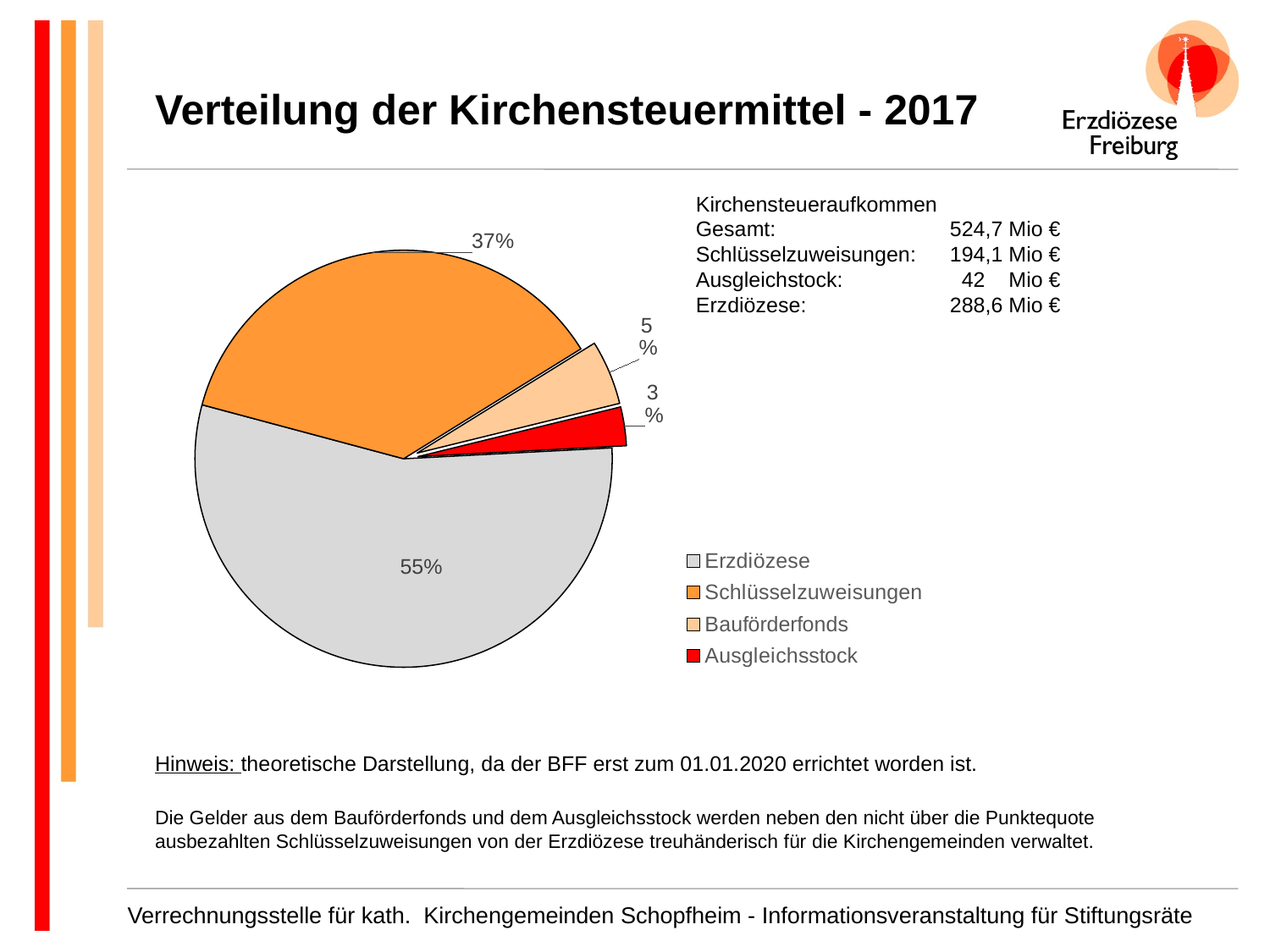
What is the difference in percentage points between the Erzdiözese slice and the Schlüsselzuweisungen slice? 18 Which slice of the pie is the largest? Erzdiözese What share of the pie does Ausgleichsstock have? 3% What share of the pie does Erzdiözese have? 55% Which is larger, the Bauförderfonds slice or the Ausgleichsstock slice? Bauförderfonds Which slice of the pie is the smallest? Ausgleichsstock What share of the pie does Bauförderfonds have? 5% How many slices does the pie chart have? 4 What kind of chart is shown on the slide? pie chart What colour is the Ausgleichsstock slice in the pie chart? red How many entries does the legend list? 4